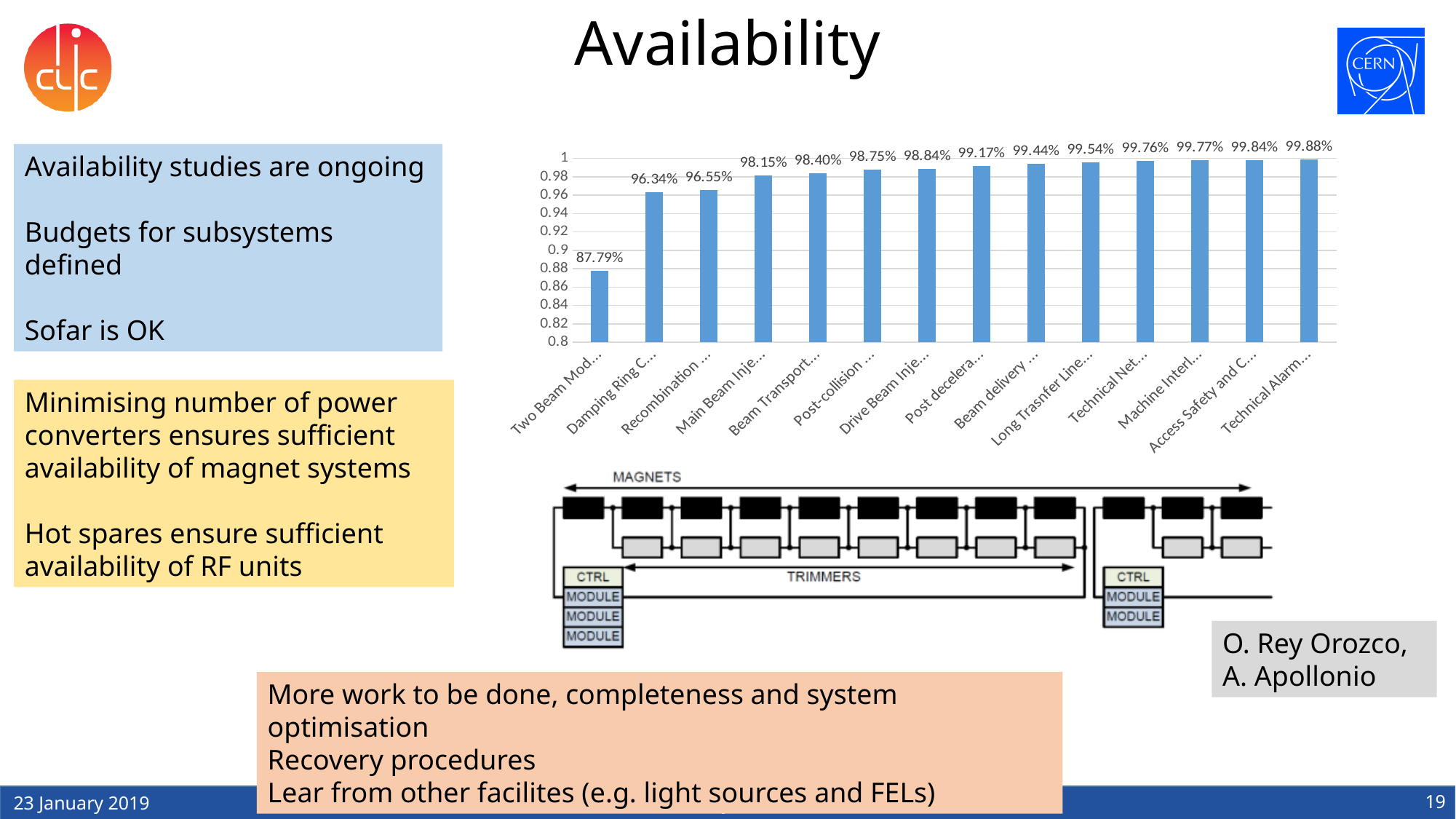
What is the availability value shown for the 'Two Beam Mod...' category? 87.79% What is the difference between the highest and lowest availability values shown in the chart? 12.09% What is the difference between the availability values for 'Recombination ...' and 'Damping Ring C...'? 0.21% Do the availability values rise or fall from left to right along the x axis? rise What is the availability value shown for the 'Damping Ring C...' category? 96.34% Is the value for 'Two Beam Mod...' greater or less than 0.9? less What kind of chart is used to show the availability values? bar chart Which category has the highest availability value in the bar chart? Technical Alarm... Which has a higher availability value, 'Main Beam Inje...' or 'Beam Transport...'? Beam Transport... Which category has the lowest availability value in the bar chart? Two Beam Mod... How many categories (bars) are shown in the availability bar chart? 14 What is the availability value shown for the 'Technical Alarm...' category? 99.88%